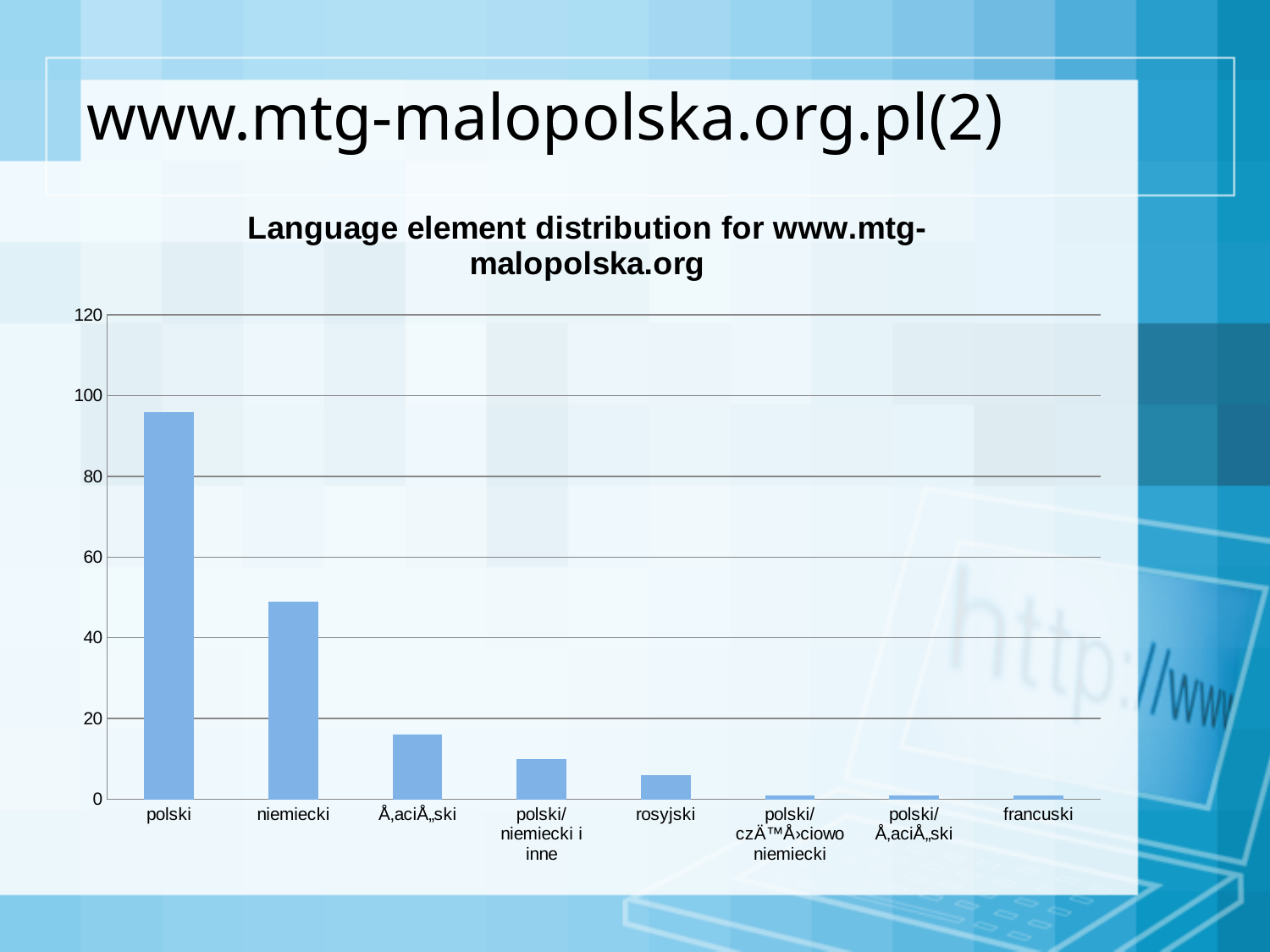
Do the bar values rise or fall from left to right along the x axis? fall Is the value for rosyjski greater or less than 20? less Which category has the highest value in the chart? polski Is the value for polski greater or less than 80? greater What is the title of the chart? Language element distribution for www.mtg-malopolska.org Is the value for polski greater or less than 100? less Which has a larger value, polski/niemiecki i inne or francuski? polski/niemiecki i inne Which has a larger value, niemiecki or rosyjski? niemiecki What kind of chart is shown on the slide? bar chart How many categories are shown on the x axis of the chart? 8